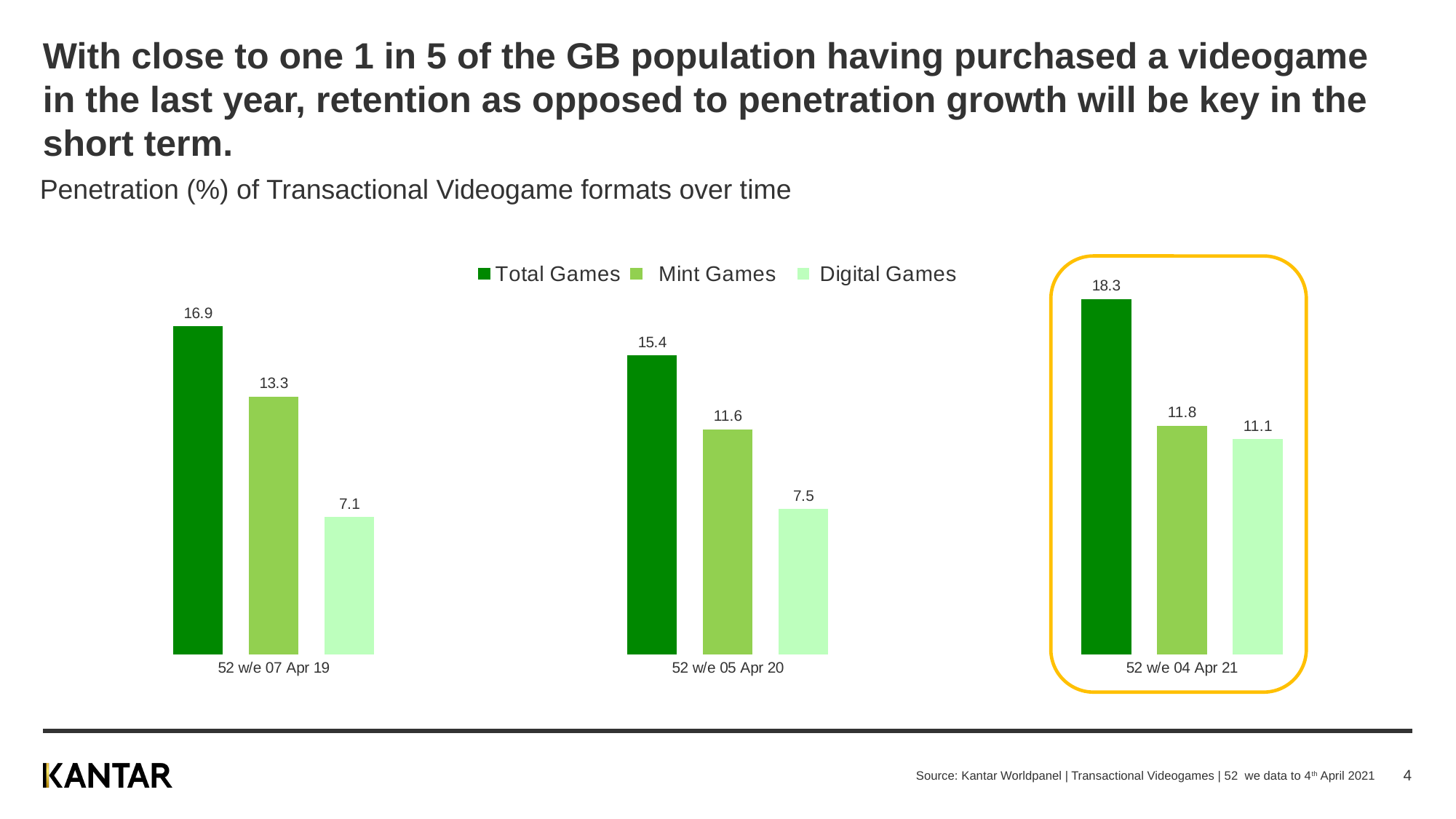
What kind of chart is shown on the slide? Bar chart Does the Digital Games value rise or fall from 52 w/e 07 Apr 19 to 52 w/e 04 Apr 21? Rise In which period is the Digital Games value lowest? 52 w/e 07 Apr 19 What is the difference between Mint Games and Digital Games in 52 w/e 07 Apr 19? 6.2 What is the difference between Total Games in 52 w/e 04 Apr 21 and 52 w/e 05 Apr 20? 2.9 What is the value for Total Games in 52 w/e 04 Apr 21? 18.3 How many time periods are shown on the x axis? 3 What is the value for Digital Games in 52 w/e 07 Apr 19? 7.1 In which period is the Total Games value highest? 52 w/e 04 Apr 21 How many series does the legend list? 3 What is the value for Mint Games in 52 w/e 05 Apr 20? 11.6 Which is larger in 52 w/e 04 Apr 21: Mint Games or Digital Games? Mint Games